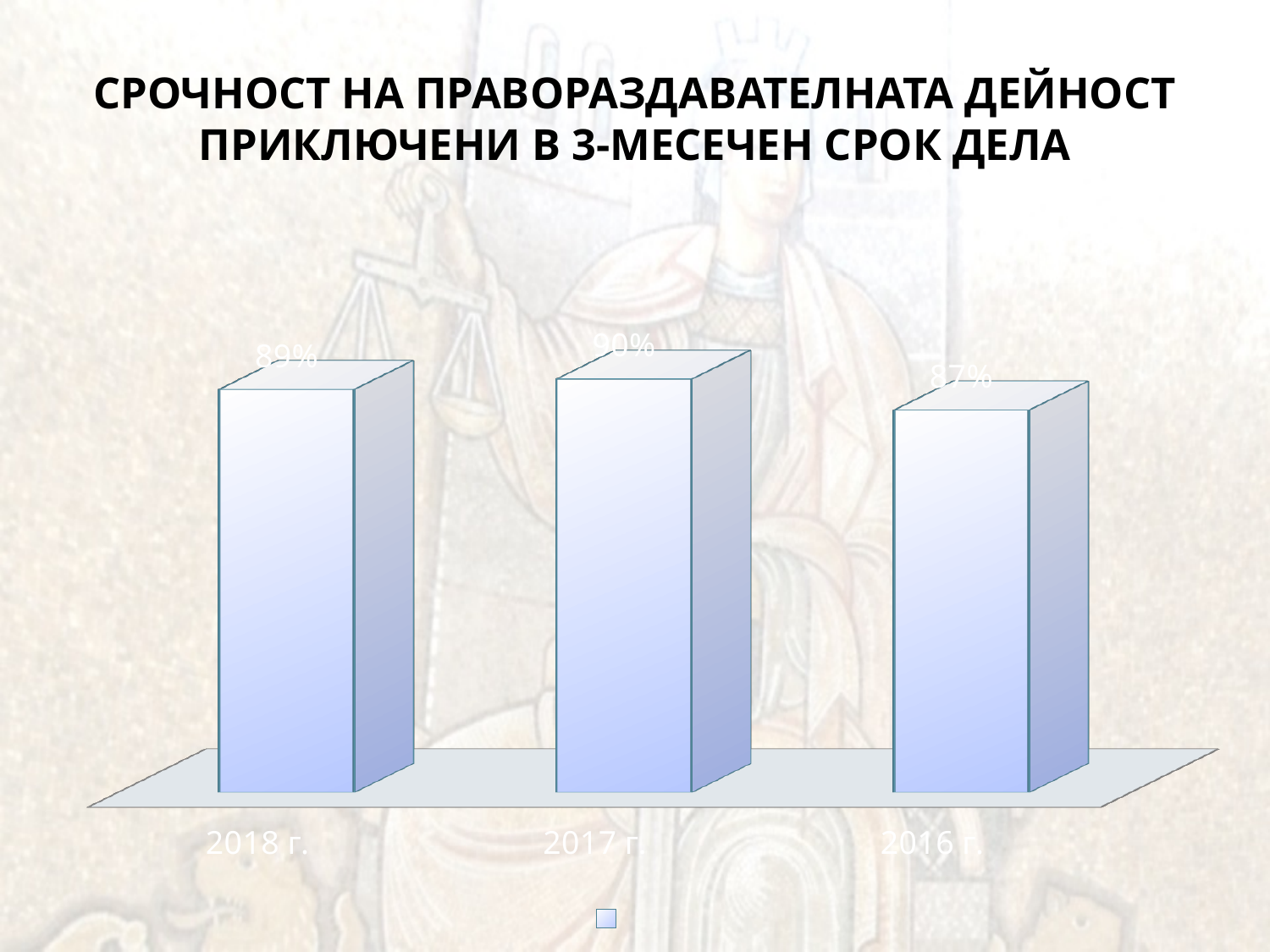
What kind of chart is shown on the slide? bar chart Which year has the highest value? 2017 г. What is the value for 2017 г.? 90% How many years are shown on the chart? 3 What is the second line of the chart title? ПРИКЛЮЧЕНИ В 3-МЕСЕЧЕН СРОК ДЕЛА What is the difference between the values for 2017 г. and 2016 г.? 3% Which is larger, the value for 2018 г. or the value for 2016 г.? 2018 г. Which year has the lowest value? 2016 г. What is the value for 2016 г.? 87% What is the difference between the values for 2018 г. and 2016 г.? 2% Does the value rise or fall from 2017 г. to 2016 г.? fall What is the value for 2018 г.? 89%